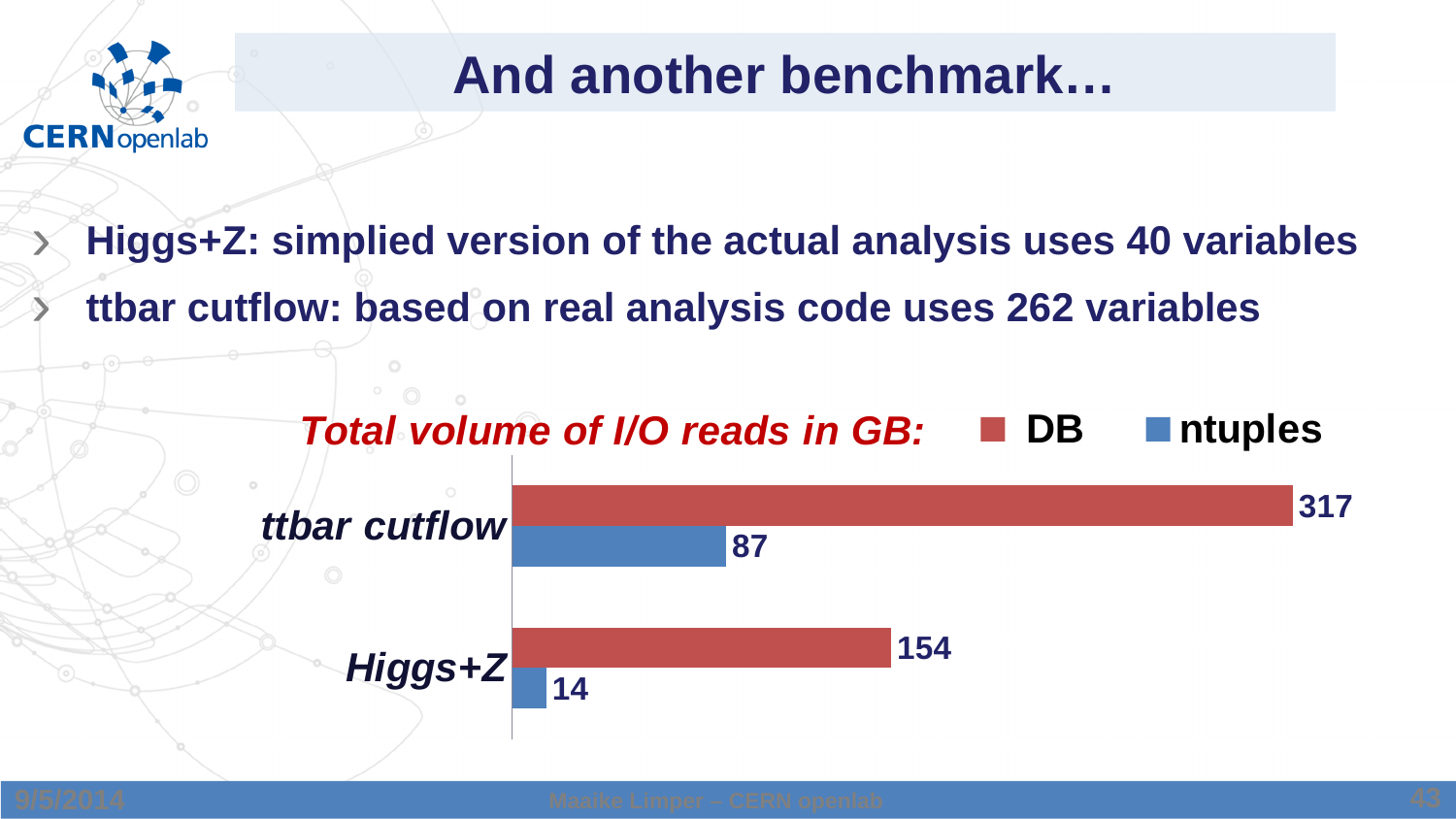
Which is larger for Higgs+Z, the DB value or the ntuples value? DB What is the DB value for ttbar cutflow? 317 How many categories are shown on the chart? 2 What is the DB value for Higgs+Z? 154 What kind of chart is shown on the slide? bar chart What is the ntuples value for Higgs+Z? 14 What is the difference between the DB values for ttbar cutflow and Higgs+Z? 163 Which category has the lowest ntuples value? Higgs+Z What is the ntuples value for ttbar cutflow? 87 How many series does the legend list? 2 What is the difference between the DB and ntuples values for ttbar cutflow? 230 Which category has the highest DB value? ttbar cutflow